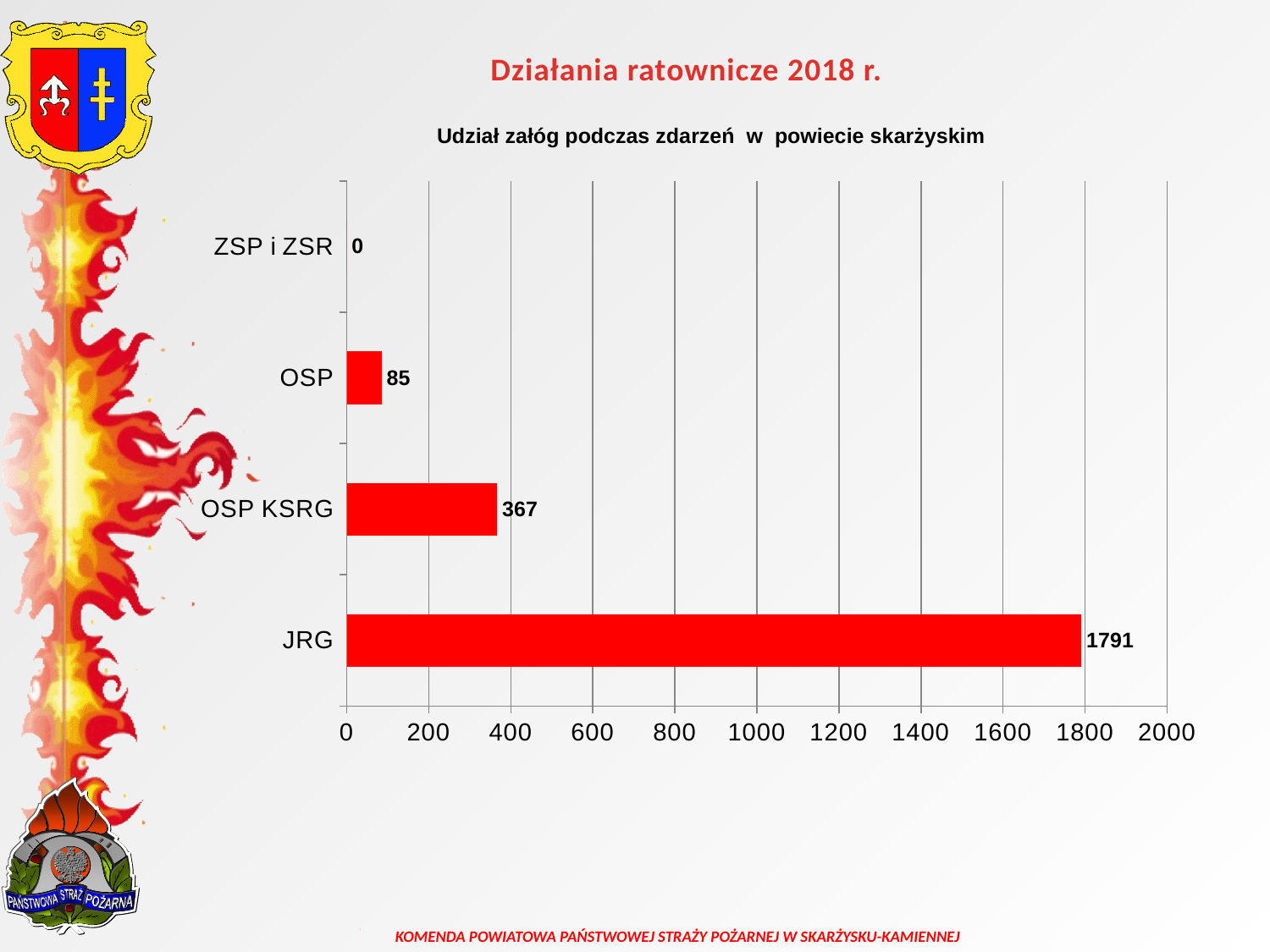
How many categories are shown in the chart? 4 What is the title of the chart? Udział załóg podczas zdarzeń w powiecie skarżyskim Which is larger, the value for OSP or the value for OSP KSRG? OSP KSRG What is the value for OSP KSRG? 367 What kind of chart is shown on the slide? Bar chart What is the value for JRG? 1791 What is the difference between the values for OSP KSRG and OSP? 282 Which category has the lowest value? ZSP i ZSR What is the difference between the values for JRG and OSP KSRG? 1424 What is the value for ZSP i ZSR? 0 What is the value for OSP? 85 Which category has the highest value? JRG